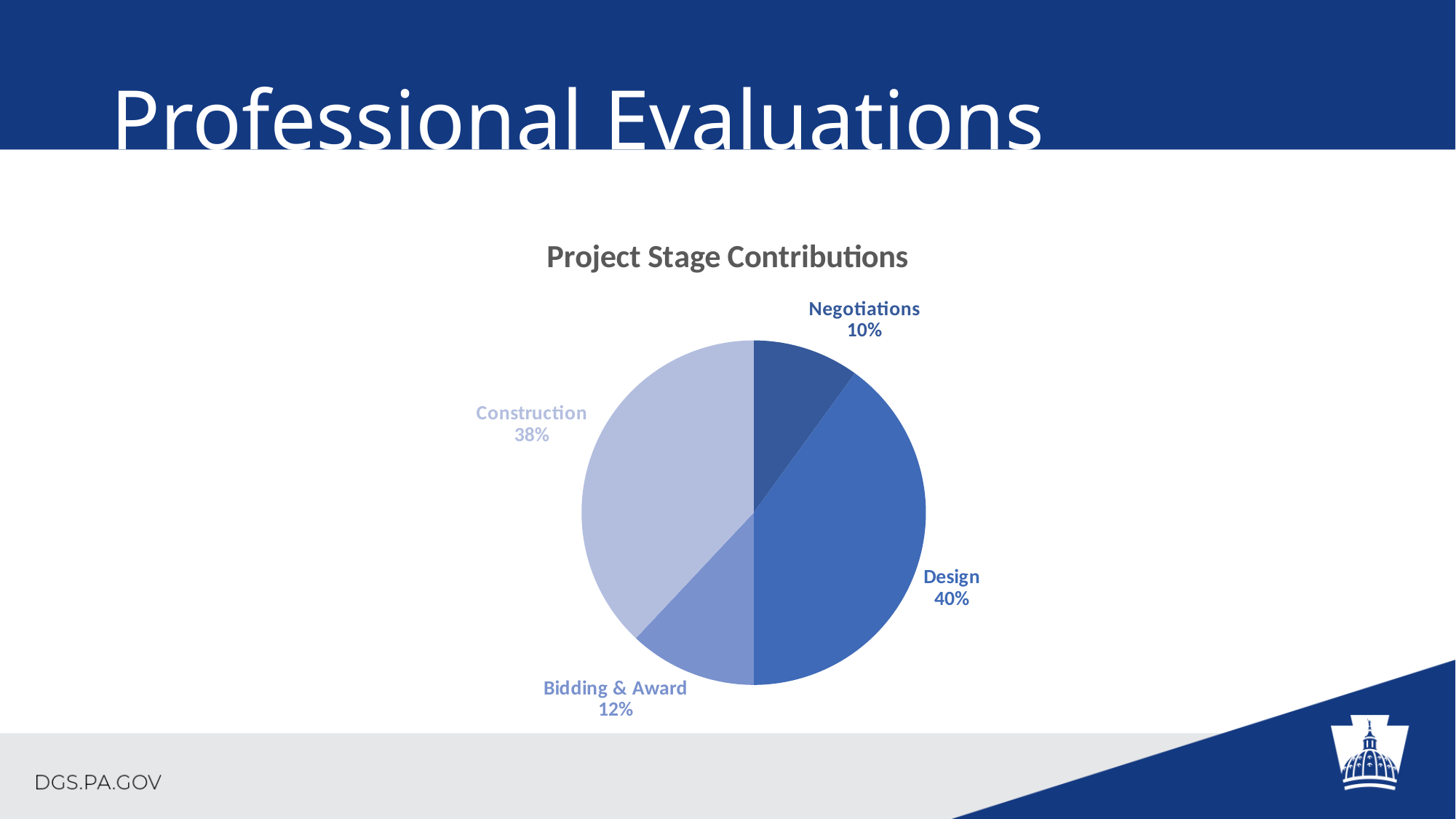
What is the value shown for Negotiations? 10% How many project stages are shown in the pie chart? 4 Which project stage has the smallest share? Negotiations What is the difference in percentage points between Design and Construction? 2 What is the difference in percentage points between Bidding & Award and Negotiations? 2 What is the value shown for Construction? 38% What is the title of the chart? Project Stage Contributions What share of the pie does Design account for? 40% Which project stage has the largest share? Design Which is larger, the share for Construction or the share for Bidding & Award? Construction What kind of chart is shown on the slide? Pie chart What is the value shown for Bidding & Award? 12%